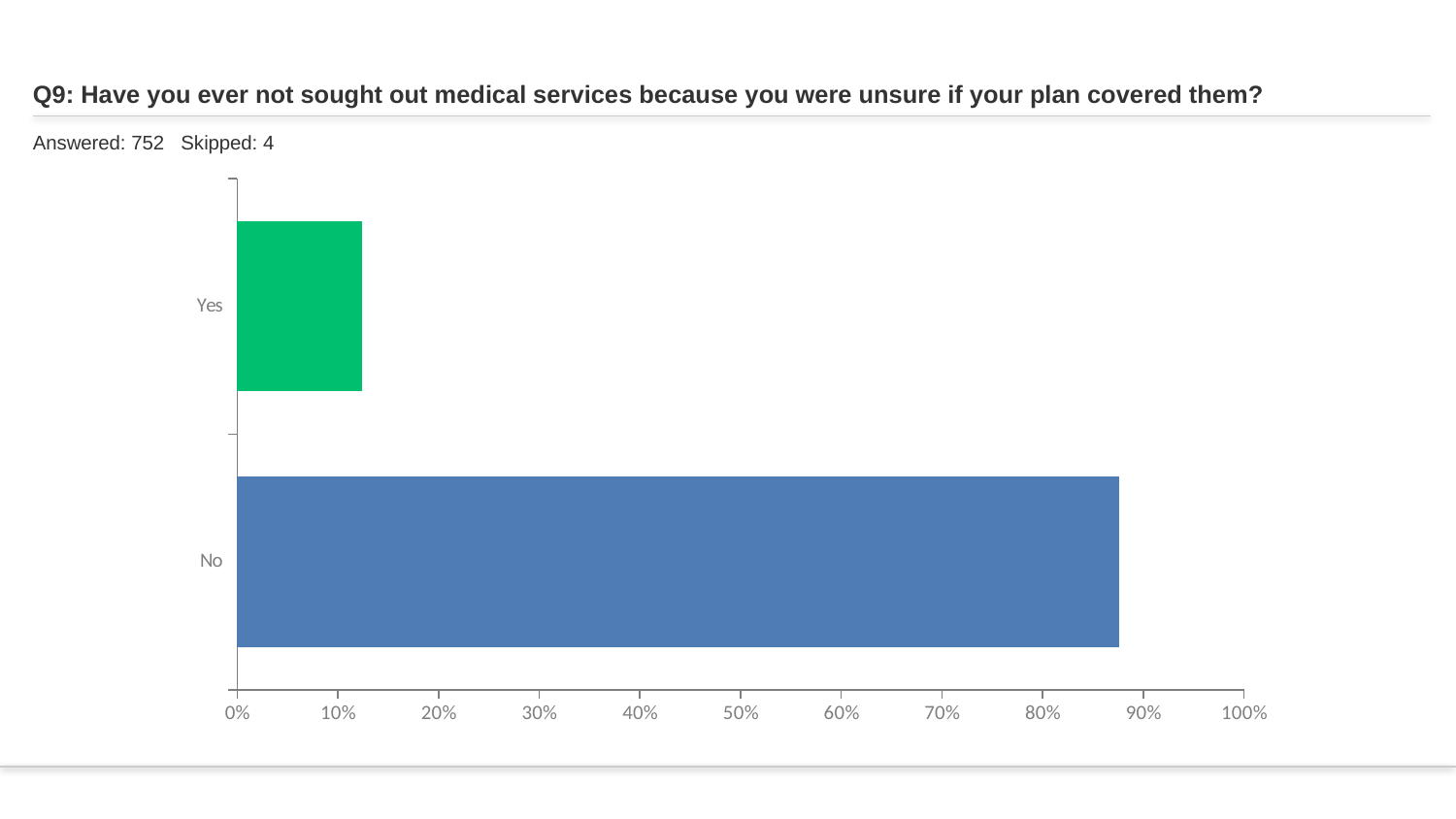
Is the value for Yes greater or less than 10%? greater Is the value for No greater or less than 90%? less Which is larger, the value for Yes or the value for No? No Which category has the highest value? No What is the maximum value shown on the x axis? 100% Which category has the lowest value? Yes How many respondents answered the question according to the slide? 752 How many categories are shown in the chart? 2 Is the value for Yes greater or less than 20%? less What kind of chart is shown on the slide? bar chart